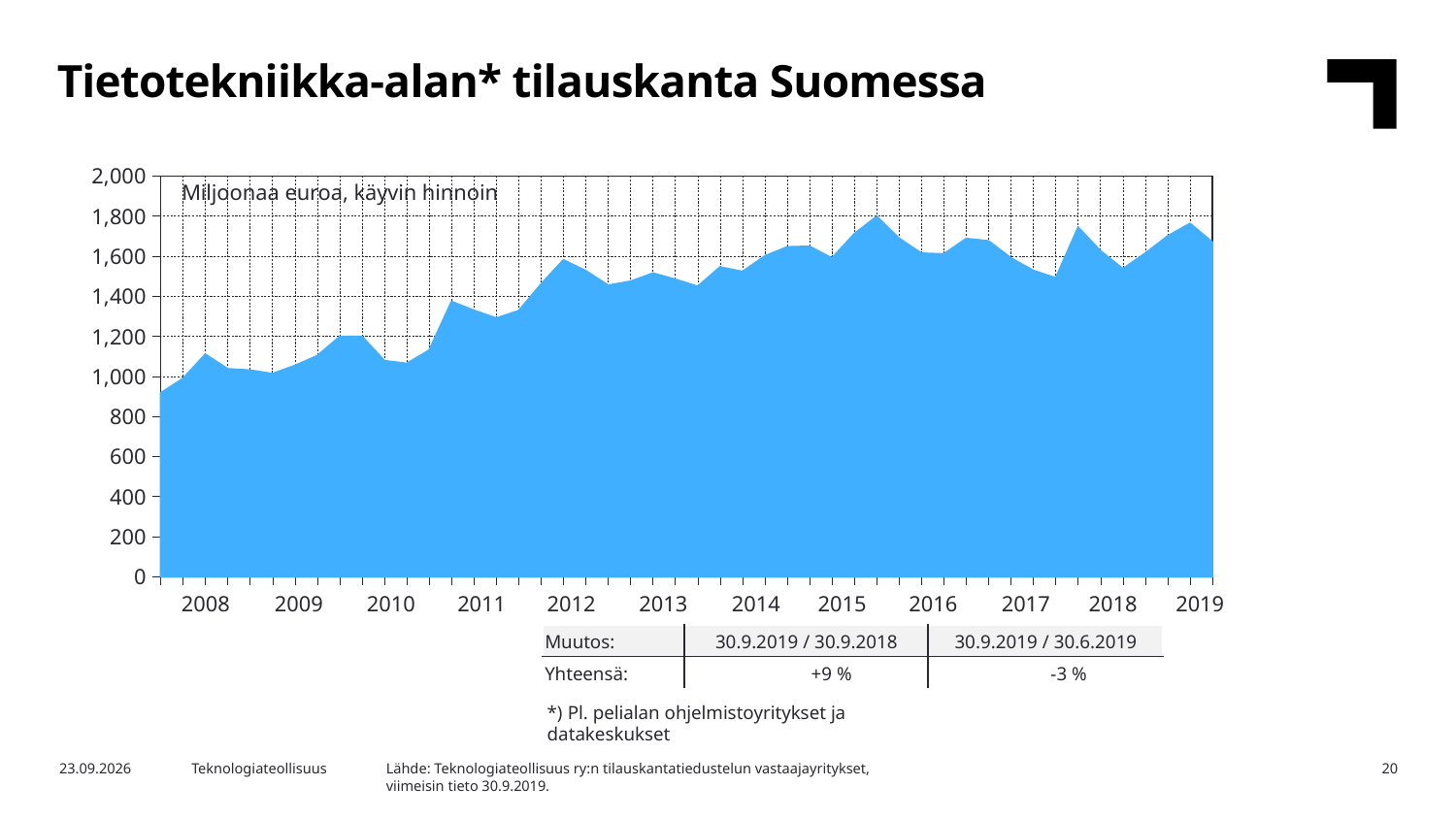
How many years are labeled on the x axis of the chart? 12 Which is larger, the value at 2010 or the value at 2012? 2012 What kind of chart is shown on the slide? area chart Overall, do the values rise or fall from 2008 to 2019? rise In which year does the chart show its lowest value? 2008 Is the value at 2019 greater or less than 1,600? greater What is the highest value shown on the y axis of the chart? 2,000 What unit is stated inside the chart area? Miljoonaa euroa, käyvin hinnoin Is the value at the start of 2008 greater or less than 1,000? less Which is larger, the value at 2008 or the value at 2019? 2019 What is the title of the chart on the slide? Tietotekniikka-alan* tilauskanta Suomessa